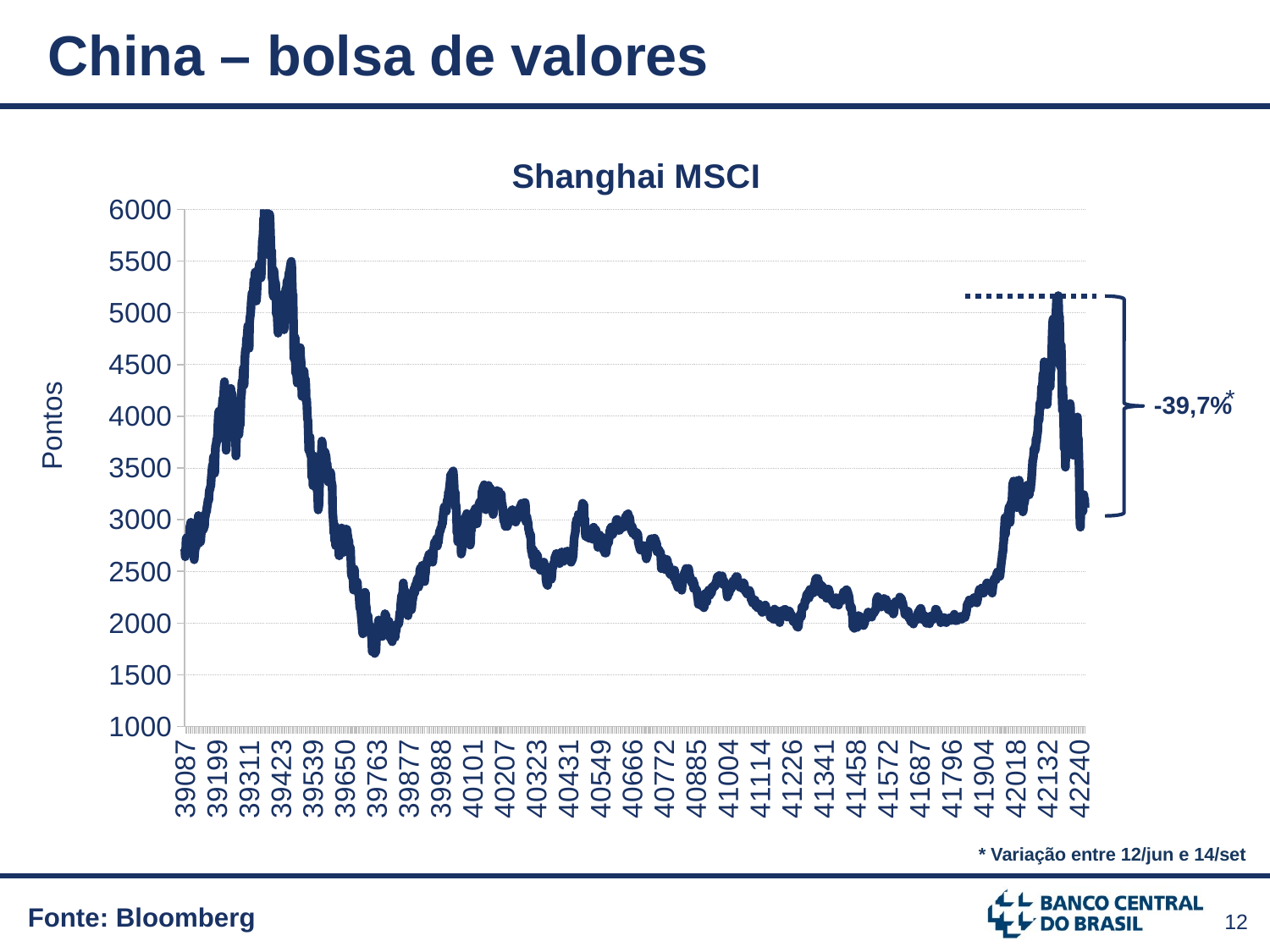
Is the peak of the line near x = 39311 greater or less than 5500? greater What is the highest value shown on the vertical axis? 6000 What is the lowest value shown on the vertical axis? 1000 Is the value of the line at x = 41687 greater or less than 2500? less What is the label of the vertical axis? Pontos What percentage change is annotated on the right side of the chart? -39,7% Does the line rise or fall between x = 41904 and x = 42132? rise What is the title of the chart? Shanghai MSCI Is the value of the line at x = 40101 greater or less than 2500? greater What kind of chart is shown on the slide? line chart Does the line rise or fall between x = 39423 and x = 39763? fall